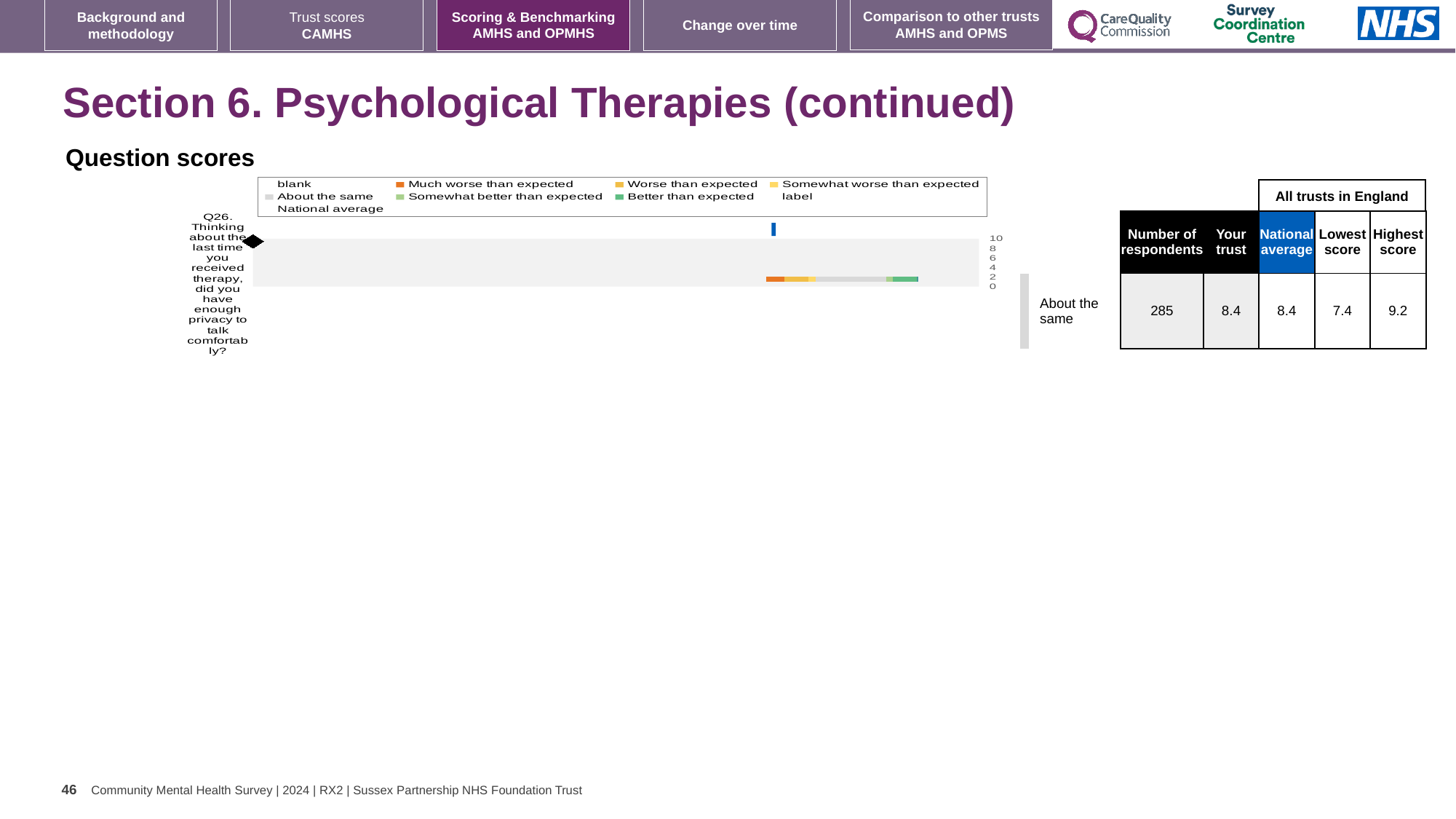
What is the highest tick value shown on the chart's score axis? 10 Which question number is plotted in the chart? Q26 How many entries does the chart legend list? 9 In the table next to the chart, how many respondents answered Q26? 285 What kind of chart is shown under 'Question scores'? bar chart In the table next to the chart, what is the highest score among all trusts in England for Q26? 9.2 What colour does the legend use for 'Much worse than expected'? orange How many questions (categories) are plotted in the chart? 1 In the table next to the chart, what is the 'Your trust' score for Q26? 8.4 In the table next to the chart, what is the lowest score among all trusts in England for Q26? 7.4 What is the difference between the highest score and the lowest score for Q26 in the table next to the chart? 1.8 In the table next to the chart, what is the national average score for Q26? 8.4